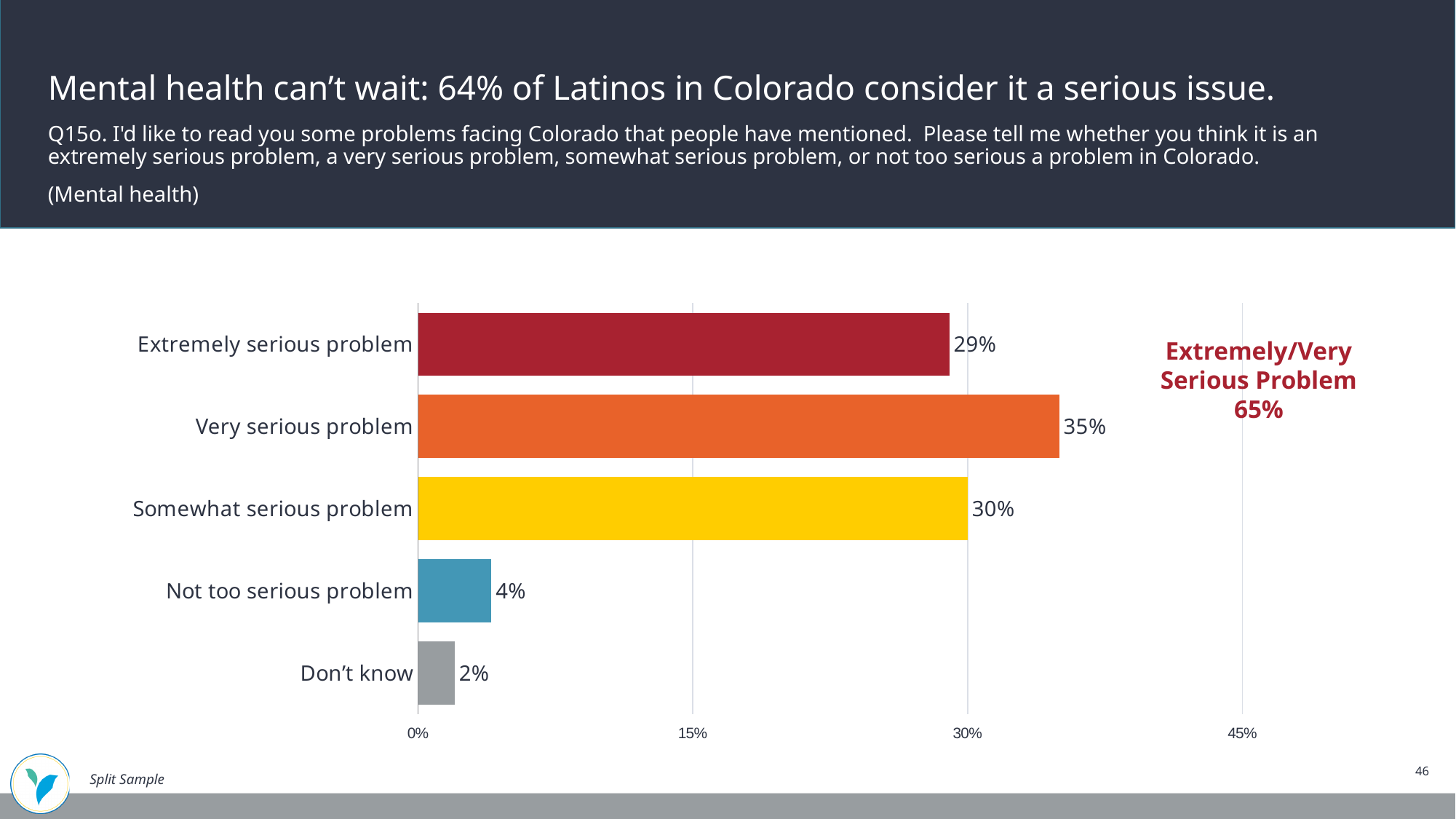
Which category has the highest value? Very serious problem Is the value for "Very serious problem" greater or less than 30%? greater What kind of chart is shown on the slide? Bar chart Which category has the lowest value? Don't know What is the value for "Very serious problem"? 35% What is the value for "Don't know"? 2% What combined percentage is shown for "Extremely/Very Serious Problem" next to the chart? 65% How many categories are shown in the chart? 5 What is the difference between "Very serious problem" and "Extremely serious problem"? 6% What percentage said "Not too serious problem"? 4% Which is larger: "Somewhat serious problem" or "Extremely serious problem"? Somewhat serious problem What percentage of respondents said mental health is an extremely serious problem? 29%